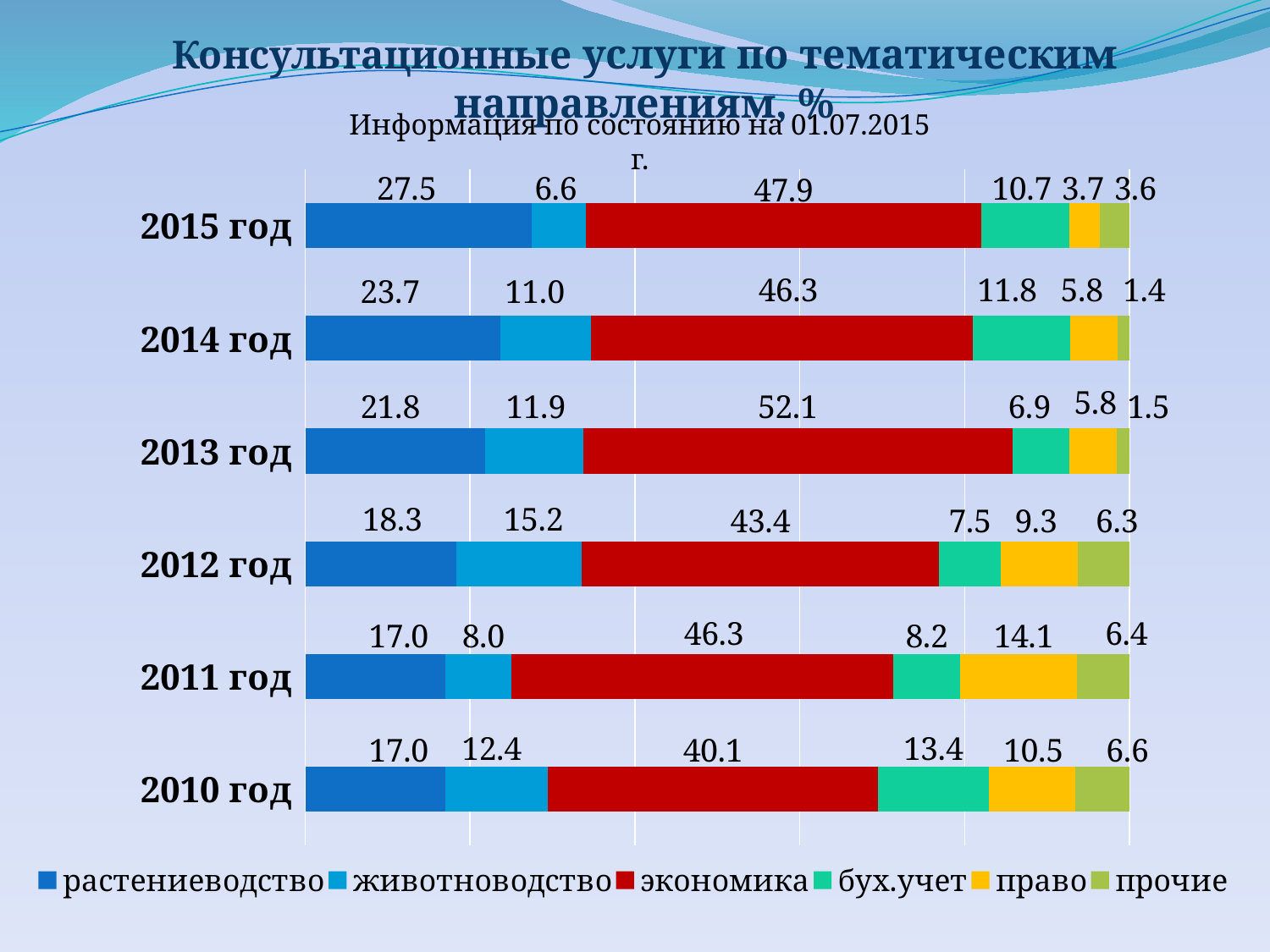
Which series is shown in red in the legend? экономика Which is larger: животноводство in 2012 год or животноводство in 2013 год? 2012 год What is the value for экономика in 2015 год? 47.9 How many years are shown on the chart? 6 In which year is the value for прочие the lowest? 2014 год What kind of chart is shown on the slide? stacked bar chart What is the value for растениеводство in 2013 год? 21.8 What is the value for бух.учет in 2010 год? 13.4 What is the difference between the растениеводство values for 2015 год and 2014 год? 3.8 What is the value for право in 2011 год? 14.1 In which year is the value for экономика the highest? 2013 год How many series does the legend list? 6